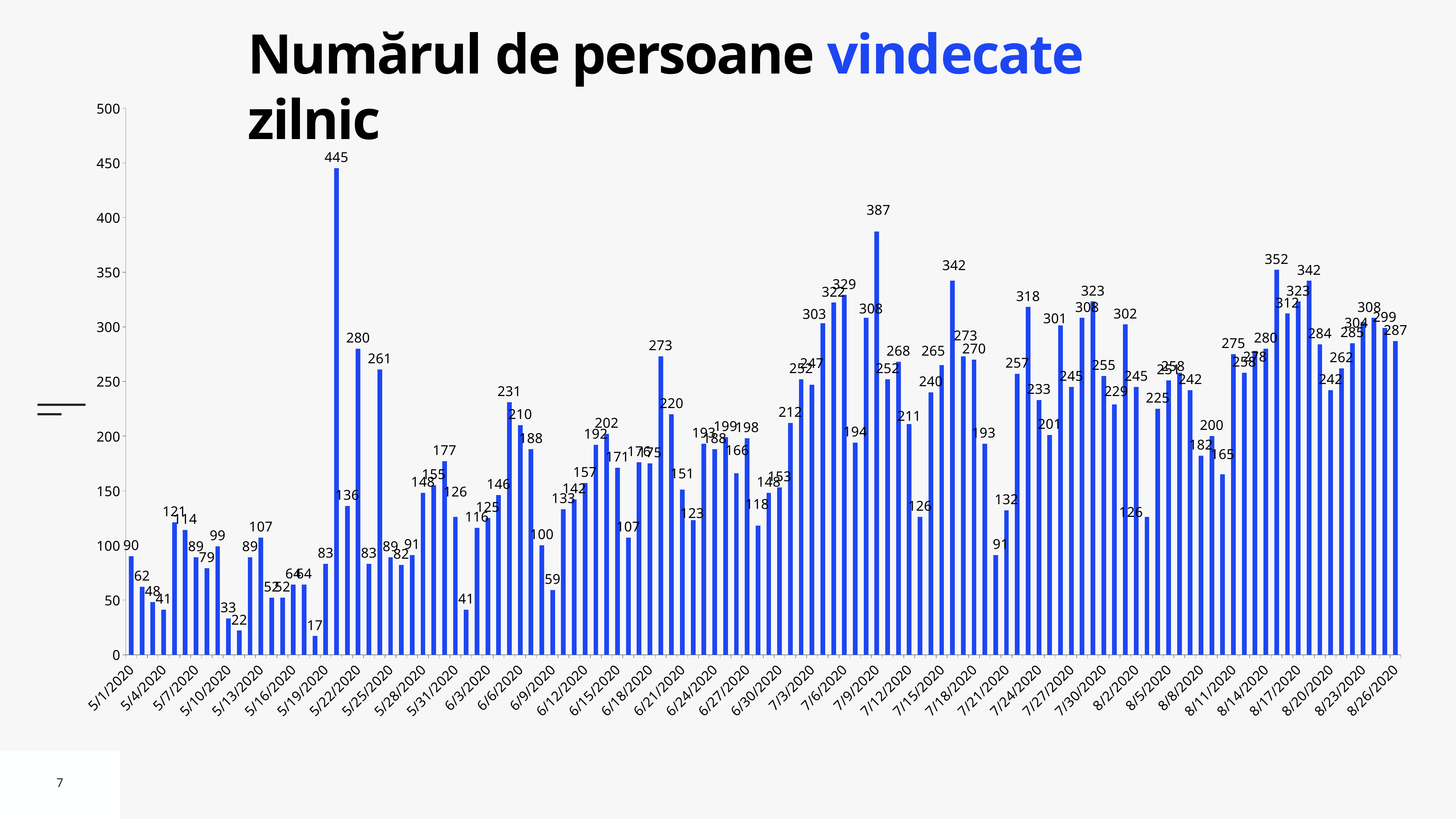
Do the values generally rise or fall from May to August along the x axis? rise What is the difference between the value for 8/26/2020 and the value for 5/1/2020? 197 What is the value for 7/9/2020? 387 What is the lowest value shown on the chart? 17 Is the value for 7/9/2020 greater or less than 350? greater What is the value for 5/22/2020? 280 What is the value for 8/26/2020? 287 What is the value for 5/1/2020? 90 What kind of chart is shown on the slide? bar chart What is the title of the chart? Numărul de persoane vindecate zilnic Which is larger, the value for 5/1/2020 or the value for 8/26/2020? 8/26/2020 What is the highest value shown on the chart? 445